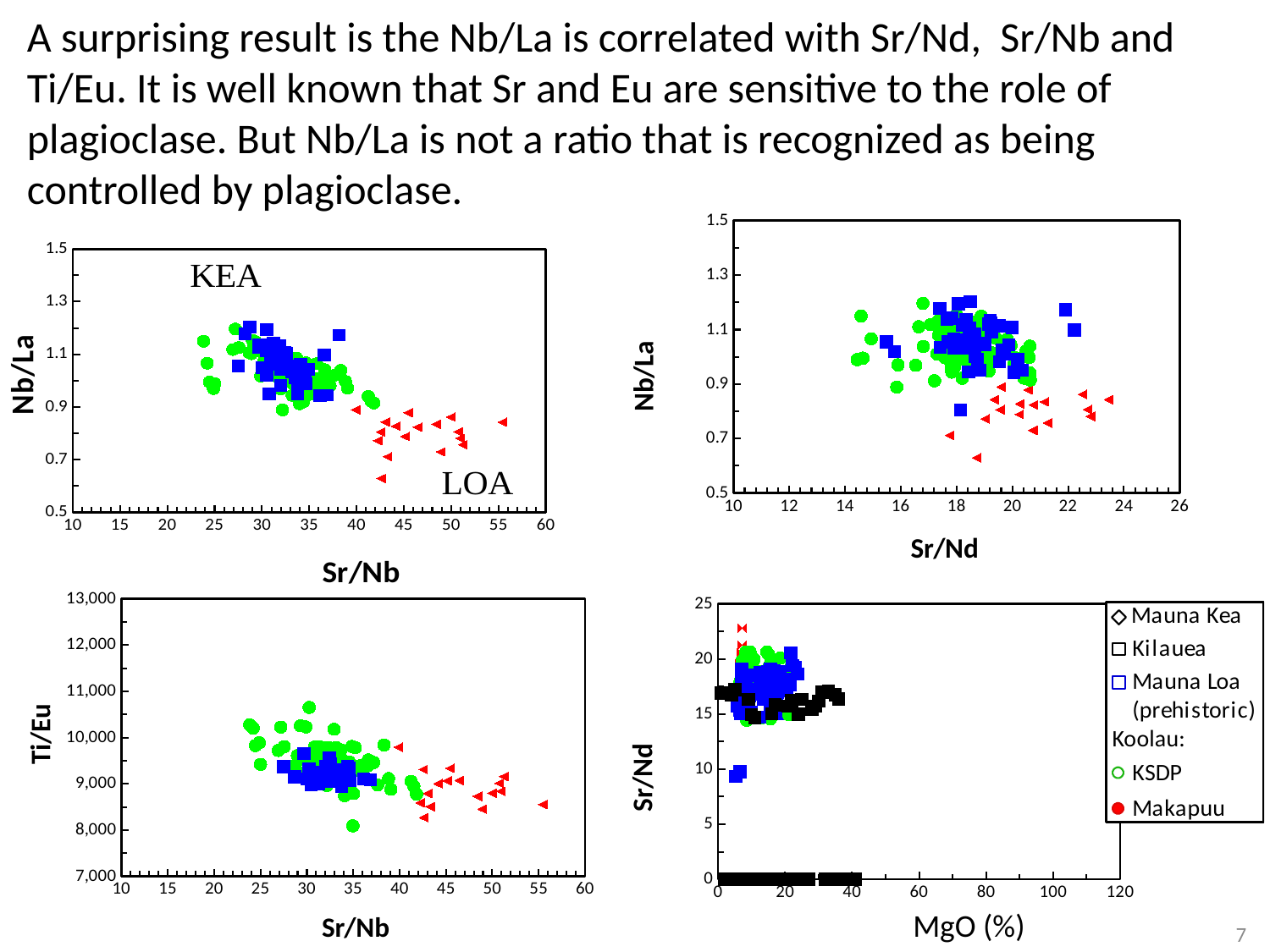
In the top-left chart (Nb/La vs Sr/Nb), are the red triangle points greater or less than 0.9 on the Nb/La axis? less How many charts are shown on the slide? 4 In the bottom-left chart (Ti/Eu vs Sr/Nb), does Ti/Eu rise or fall as Sr/Nb increases? fall How many series does the legend of the bottom-right chart (Sr/Nd vs MgO) list? 5 In the bottom-left chart (Ti/Eu vs Sr/Nb), are the blue square points greater or less than 10,000 on the Ti/Eu axis? less What is the x-axis label of the top-right chart? Sr/Nd In the top-right chart (Nb/La vs Sr/Nd), are the red triangle points greater or less than 1.1 on the Nb/La axis? less In the legend of the bottom-right chart, what colour is the KSDP marker? green In the top-left chart (Nb/La vs Sr/Nb), does Nb/La rise or fall as Sr/Nb increases? fall What kind of chart is the top-left chart with Nb/La on the y axis and Sr/Nb on the x axis? scatter chart